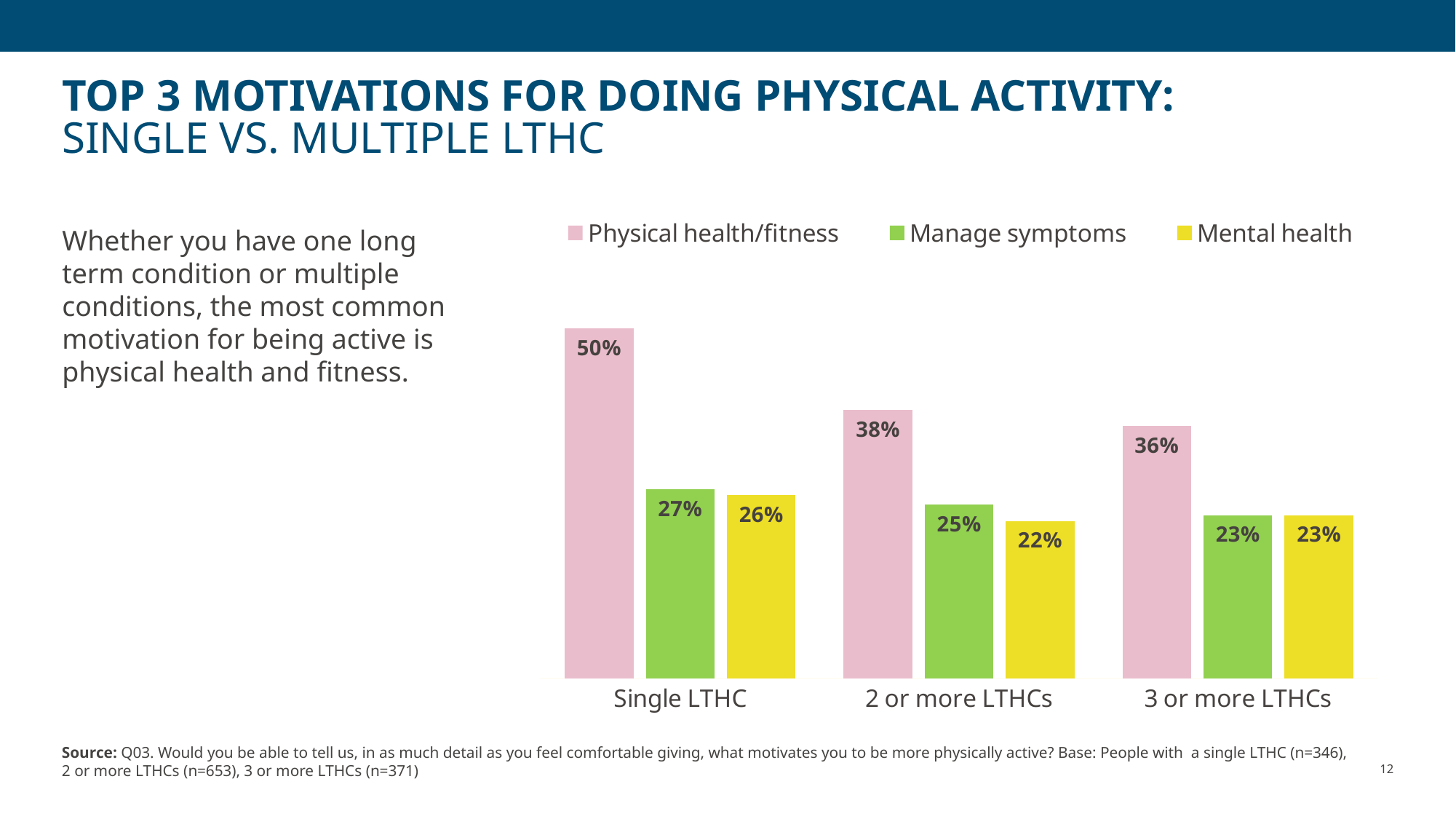
How many groups are shown on the x axis? 3 Which group has the lowest value for Mental health? 2 or more LTHCs What is the value for Manage symptoms in the 2 or more LTHCs group? 25% What is the difference between Physical health/fitness for Single LTHC and for 3 or more LTHCs? 14% What is the value for Physical health/fitness in the Single LTHC group? 50% Does the value for Physical health/fitness rise or fall from Single LTHC to 3 or more LTHCs? Fall Which group has the highest value for Physical health/fitness? Single LTHC What is the value for Mental health in the 3 or more LTHCs group? 23% What kind of chart is shown on the slide? Bar chart What is the difference between Physical health/fitness and Manage symptoms in the Single LTHC group? 23% Which is larger in the 2 or more LTHCs group: Manage symptoms or Mental health? Manage symptoms How many series does the legend list? 3